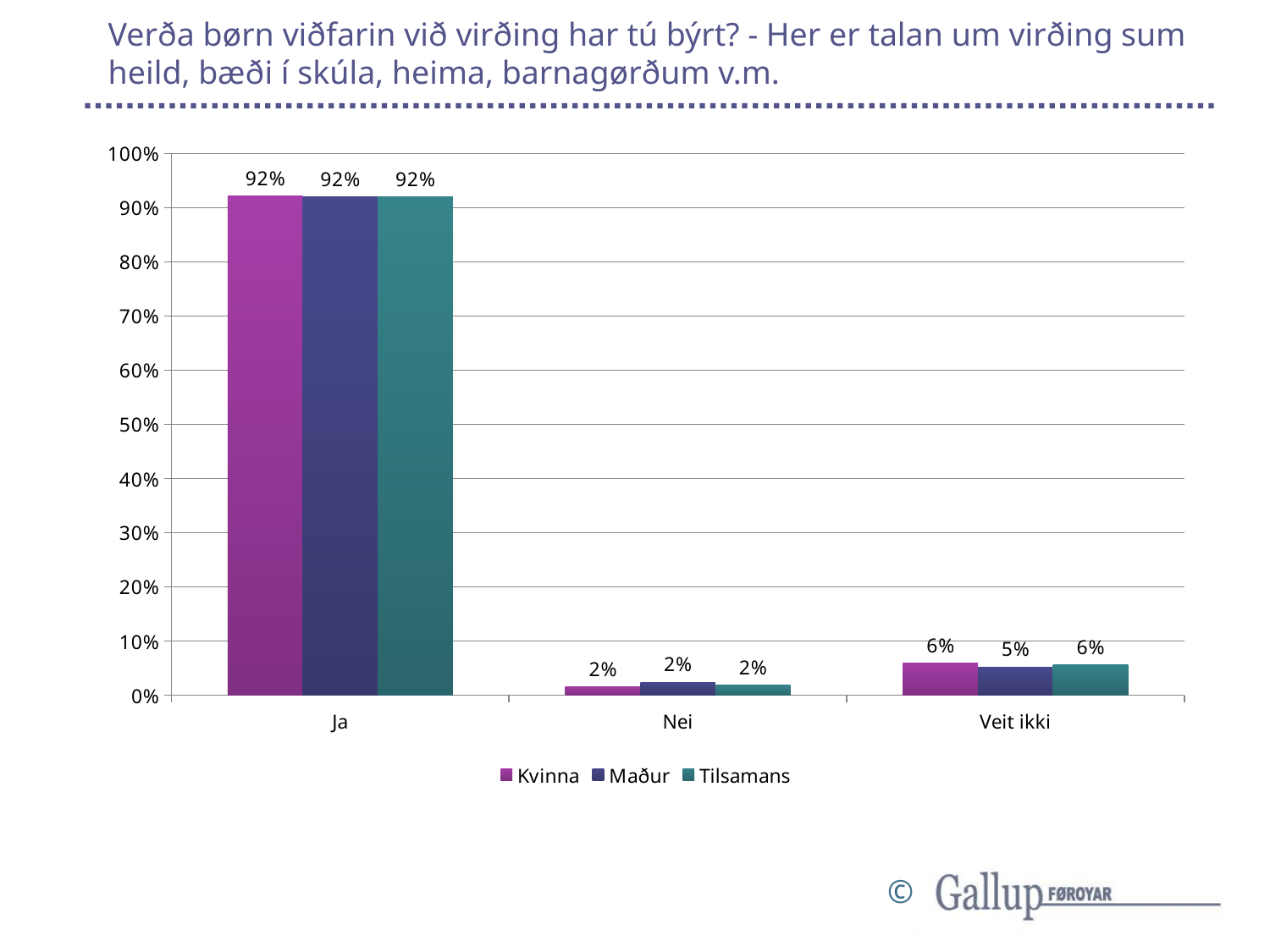
What kind of chart is shown on the slide? bar chart What is the difference between the Kvinna values for Ja and Veit ikki? 86% Which category has the lowest value for Maður? Nei Is the value for Tilsamans in the Ja category greater or less than 90%? greater What is the value for Maður in the Veit ikki category? 5% How many categories are shown on the x axis? 3 Which is larger: the Kvinna value for Nei or the Kvinna value for Veit ikki? Veit ikki What is the value for Kvinna in the Veit ikki category? 6% What is the value for Tilsamans in the Nei category? 2% Which category has the highest value for Tilsamans? Ja What is the value for Kvinna in the Ja category? 92% How many series does the legend list? 3